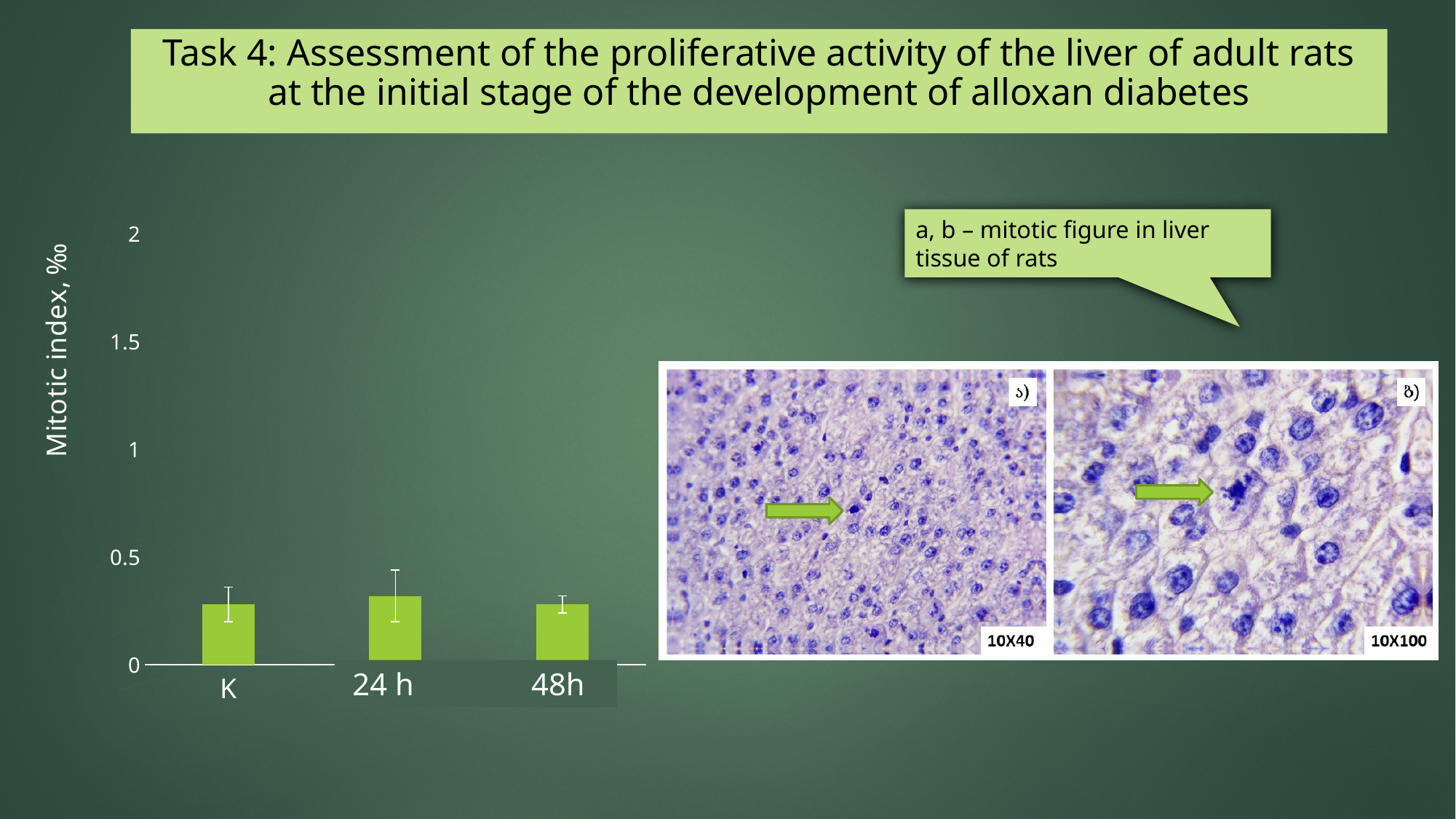
Is the value for 48h greater or less than 0.5? less What kind of chart is shown on the slide? bar chart Is the value for K greater or less than 0.5? less Is the value for 24 h greater or less than 1? less What is the label of the y axis of the chart? Mitotic index, ‰ How many categories are plotted on the x axis of the chart? 3 What is the highest tick value shown on the y axis of the chart? 2